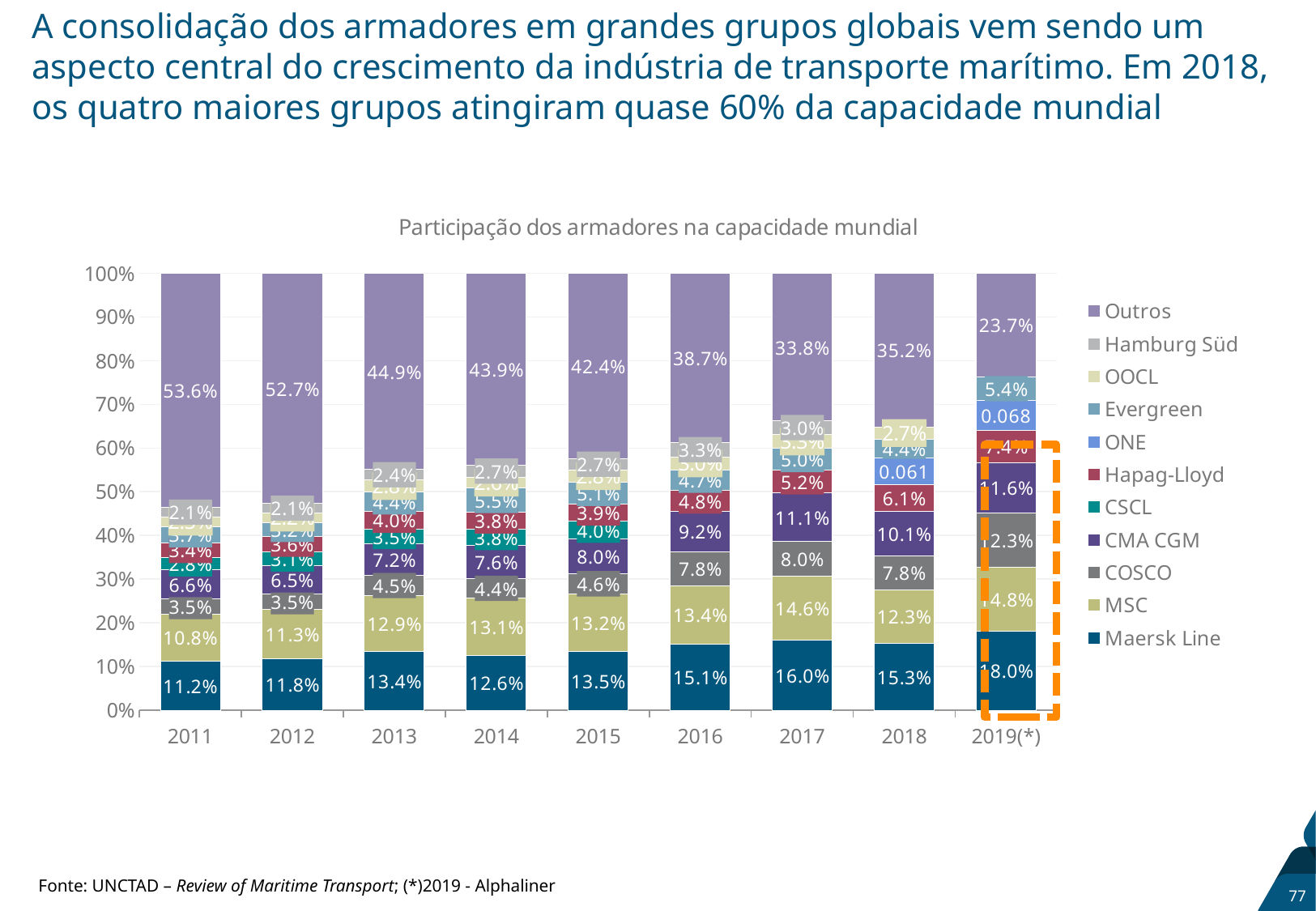
What is the value for CMA CGM in 2016? 9.2% What is the value for COSCO in 2017? 8.0% Does the Outros share generally rise or fall from 2011 to 2019(*)? Fall What is the difference between the MSC share in 2017 and in 2018? 2.3% Which is larger in 2018: the COSCO share or the CMA CGM share? CMA CGM What kind of chart is shown on the slide? Stacked bar chart In which year is the Maersk Line share the highest? 2019(*) What is the value for Maersk Line in 2019(*)? 18.0% How many series does the legend list? 11 How many years are shown on the x axis? 9 In which year is the Outros share the lowest? 2019(*) What is the value for Outros in 2011? 53.6%